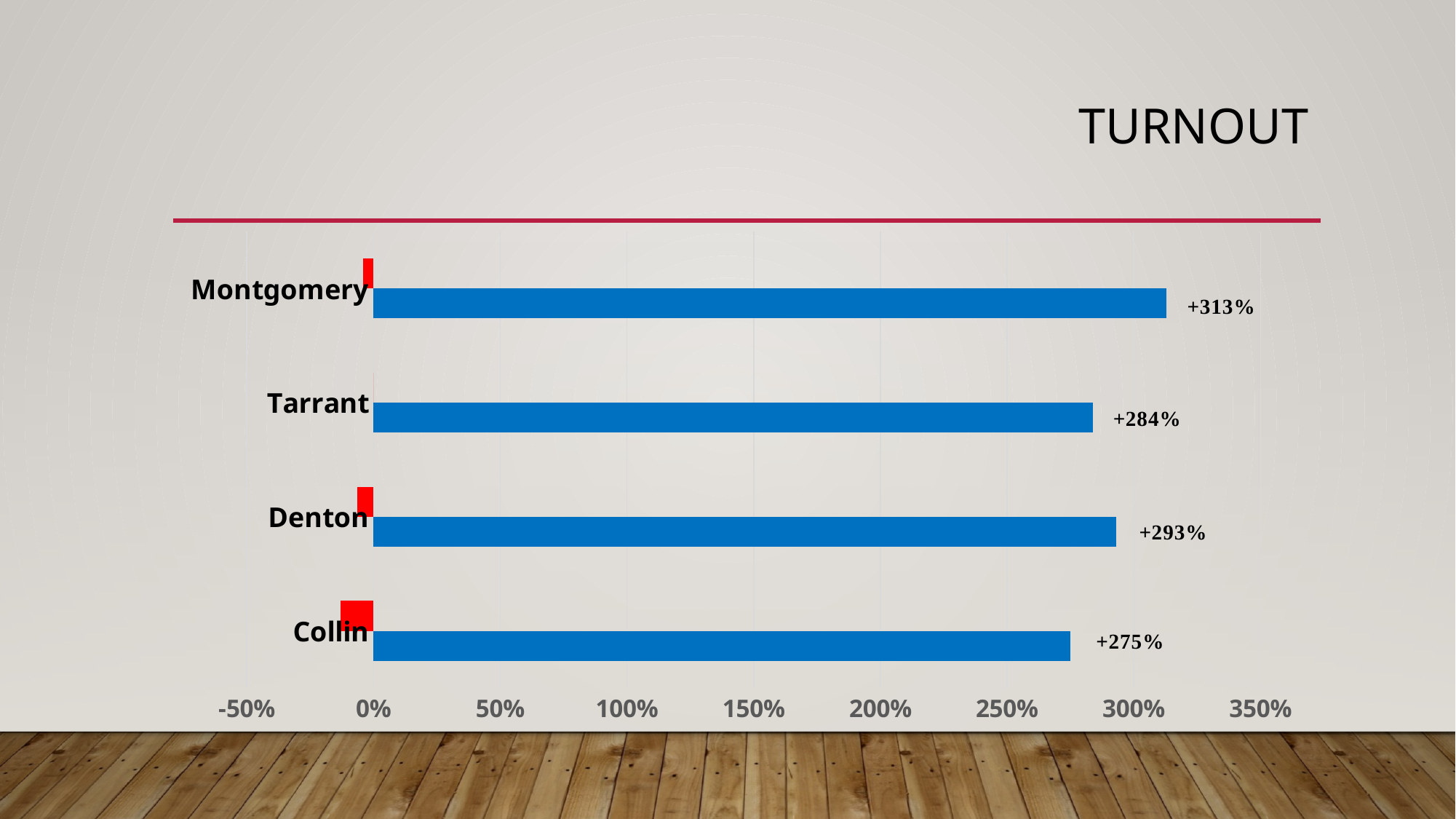
What is the labelled value for Collin? +275% Which county has the highest labelled value? Montgomery Which county has the lowest labelled value? Collin What is the difference between the labelled values for Denton and Tarrant? 9% How many counties are shown on the chart? 4 Which has a larger labelled value, Tarrant or Denton? Denton What is the labelled value for Montgomery? +313% What is the labelled value for Tarrant? +284% What is the title of the slide? TURNOUT What is the labelled value for Denton? +293% What kind of chart is shown on the slide? Bar chart What is the difference between the labelled values for Montgomery and Collin? 38%